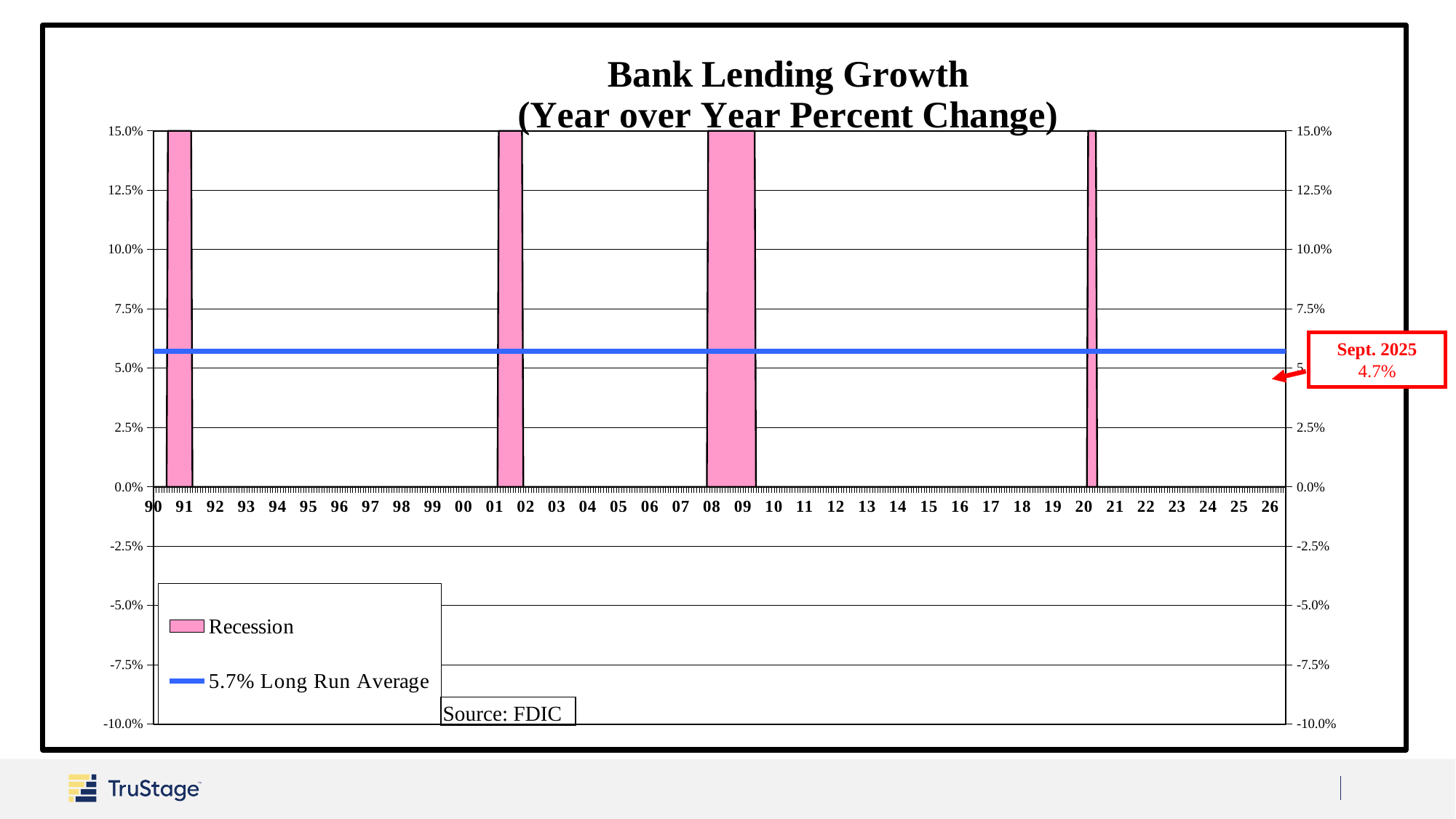
What value is given for Sept. 2025 in the annotation? 4.7% What is the difference between the 5.7% long run average and the Sept. 2025 value of 4.7%? 1.0% How many entries does the chart's legend list? 2 Is the long run average greater or less than 5.0%? greater Which is larger, the Sept. 2025 value or the long run average? the long run average Is the Sept. 2025 value greater or less than 5.0%? less What source is cited for the chart's data? FDIC What is the long run average value shown by the blue line? 5.7% How many shaded recession periods are shown on the chart? 4 What is the title of the chart? Bank Lending Growth (Year over Year Percent Change)